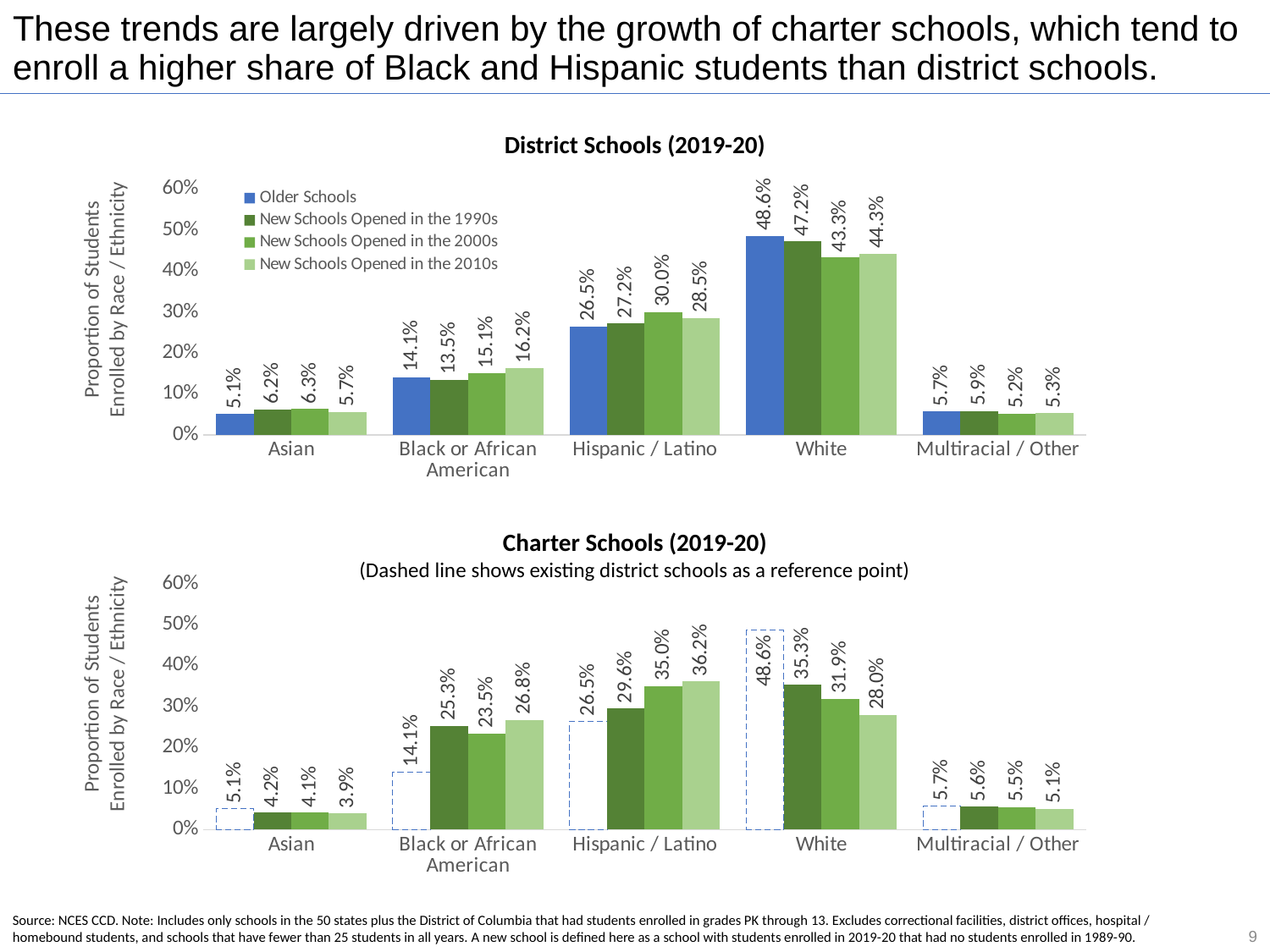
In the Charter Schools (2019-20) chart, what is the value for New Schools Opened in the 2010s in the Hispanic / Latino category? 36.2% In the District Schools (2019-20) chart, what is the difference between the Older Schools value and the New Schools Opened in the 2010s value in the White category? 4.3% How many series does the legend of the District Schools (2019-20) chart list? 4 In the District Schools (2019-20) chart, what is the value for Older Schools in the White category? 48.6% How many race / ethnicity categories are shown on the x axis of the District Schools (2019-20) chart? 5 In the Charter Schools (2019-20) chart, which category has the lowest value for New Schools Opened in the 2010s? Asian In the Charter Schools (2019-20) chart, which category has the highest value for New Schools Opened in the 1990s? White What type of chart is the Charter Schools (2019-20) chart? Bar chart In the Charter Schools (2019-20) chart, is the value for New Schools Opened in the 2010s in the White category greater or less than 30%? less In the Charter Schools (2019-20) chart, which is larger in the Black or African American category: New Schools Opened in the 1990s or New Schools Opened in the 2000s? New Schools Opened in the 1990s According to the subtitle of the Charter Schools (2019-20) chart, what does the dashed line show? Existing district schools as a reference point In the District Schools (2019-20) chart, what is the value for New Schools Opened in the 2000s in the Black or African American category? 15.1%